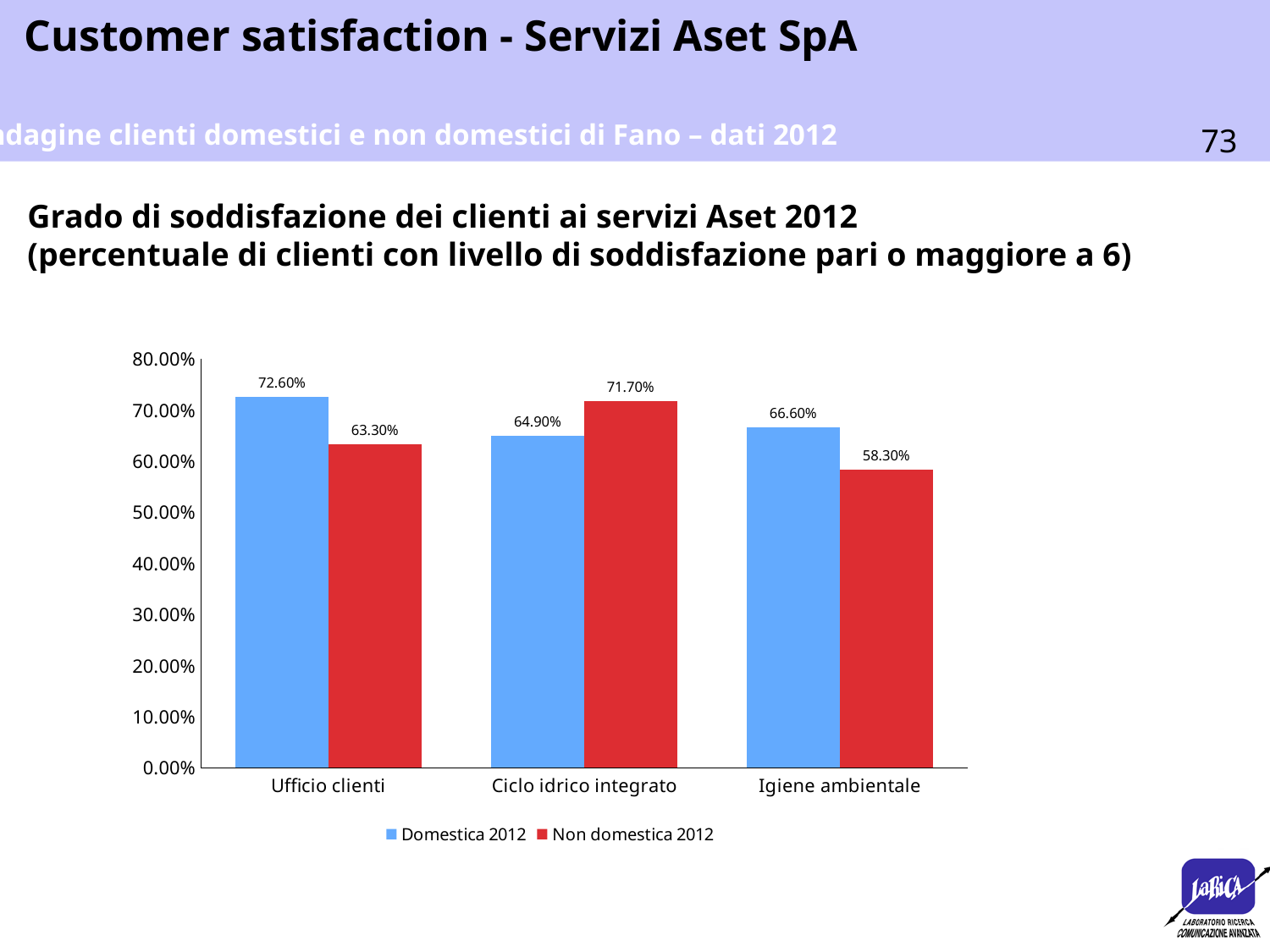
Which category has the lowest value for Non domestica 2012? Igiene ambientale What colour are the Non domestica 2012 bars? red What is the value for Domestica 2012 in the Ufficio clienti category? 72.60% What is the value for Non domestica 2012 in the Igiene ambientale category? 58.30% What is the difference between the Domestica 2012 and Non domestica 2012 values for Ufficio clienti? 9.30% Which is larger for Ciclo idrico integrato: Domestica 2012 or Non domestica 2012? Non domestica 2012 How many categories are shown on the x axis? 3 How many series does the legend list? 2 What is the value for Non domestica 2012 in the Ciclo idrico integrato category? 71.70% What kind of chart is shown on the slide? bar chart Is the value for Non domestica 2012 in Igiene ambientale greater or less than 60.00%? less Which category has the highest value for Domestica 2012? Ufficio clienti